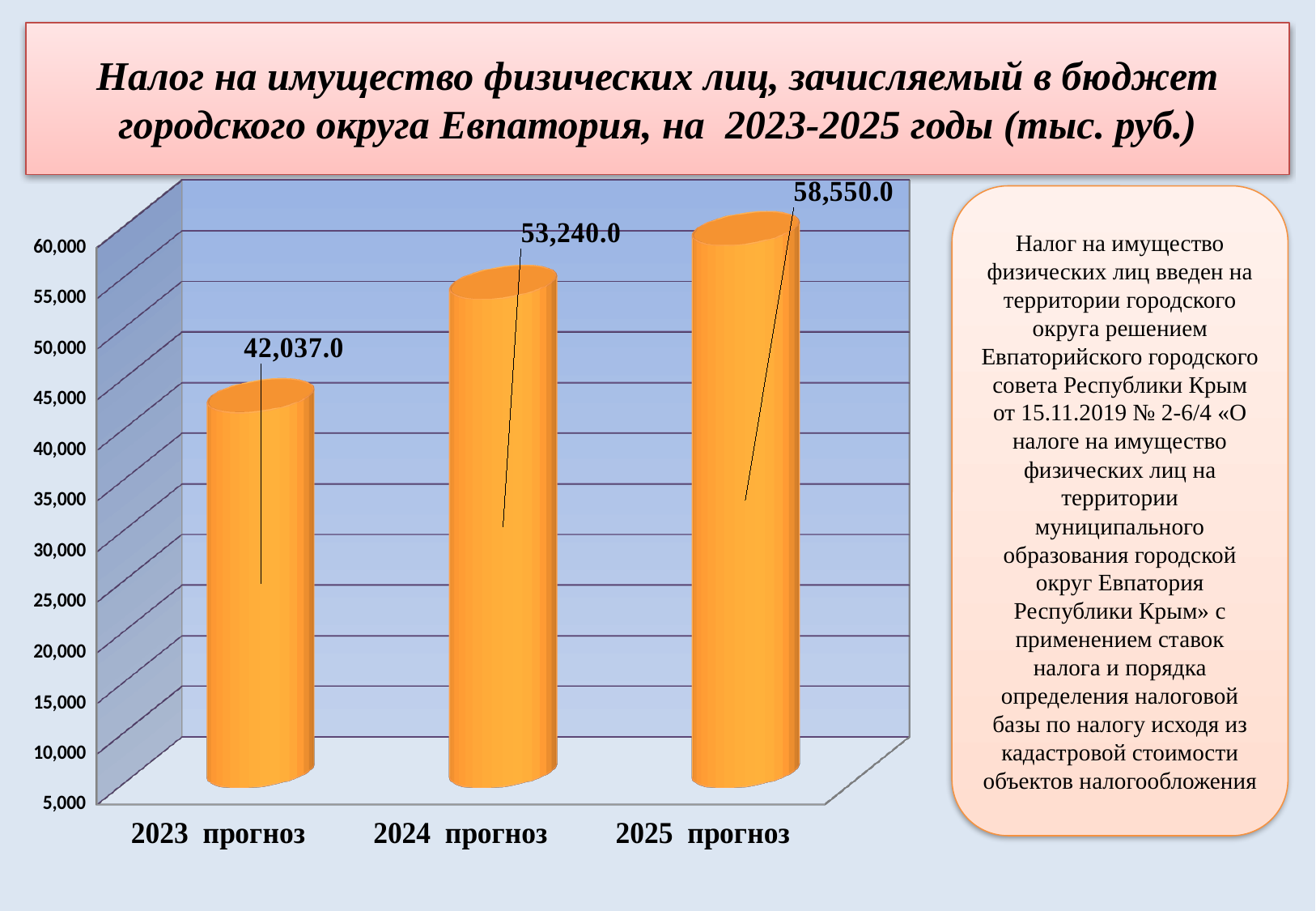
Which year has the lowest value? 2023 прогноз What is the value for 2023 прогноз? 42,037.0 How many categories are shown on the x axis? 3 What is the difference between the values for 2024 прогноз and 2023 прогноз? 11,203.0 What kind of chart is shown on the slide? bar chart What is the value for 2024 прогноз? 53,240.0 Is the value for 2025 прогноз greater or less than 55,000? greater Which year has the highest value? 2025 прогноз What is the difference between the values for 2025 прогноз and 2024 прогноз? 5,310.0 Do the values rise or fall from 2023 to 2025? rise What is the value for 2025 прогноз? 58,550.0 Which is larger, the value for 2023 прогноз or 2024 прогноз? 2024 прогноз